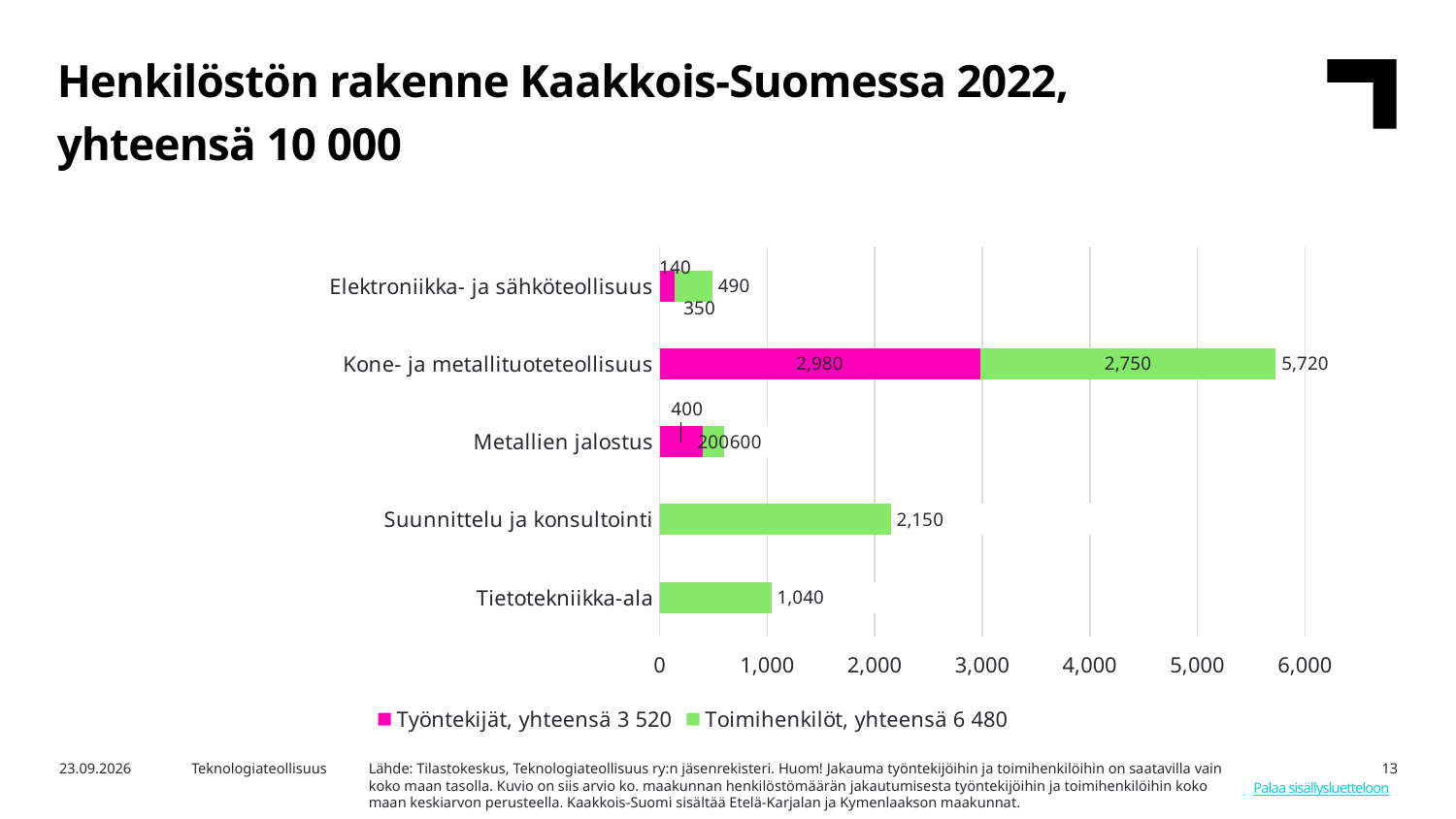
What is the Toimihenkilöt value for Kone- ja metallituoteteollisuus? 2,750 What is the Toimihenkilöt value for Tietotekniikka-ala? 1,040 What is the total of the stacked bar for Kone- ja metallituoteteollisuus? 5,720 Which category has the smallest total bar? Elektroniikka- ja sähköteollisuus Which category has the largest total bar? Kone- ja metallituoteteollisuus How many categories are shown on the chart? 5 What is the difference between the Työntekijät and Toimihenkilöt values for Kone- ja metallituoteteollisuus? 230 Which has a larger total bar, Suunnittelu ja konsultointi or Tietotekniikka-ala? Suunnittelu ja konsultointi What is the total of the stacked bar for Elektroniikka- ja sähköteollisuus? 490 What is the Työntekijät value for Kone- ja metallituoteteollisuus? 2,980 How many series does the legend list? 2 What is the Toimihenkilöt value for Suunnittelu ja konsultointi? 2,150